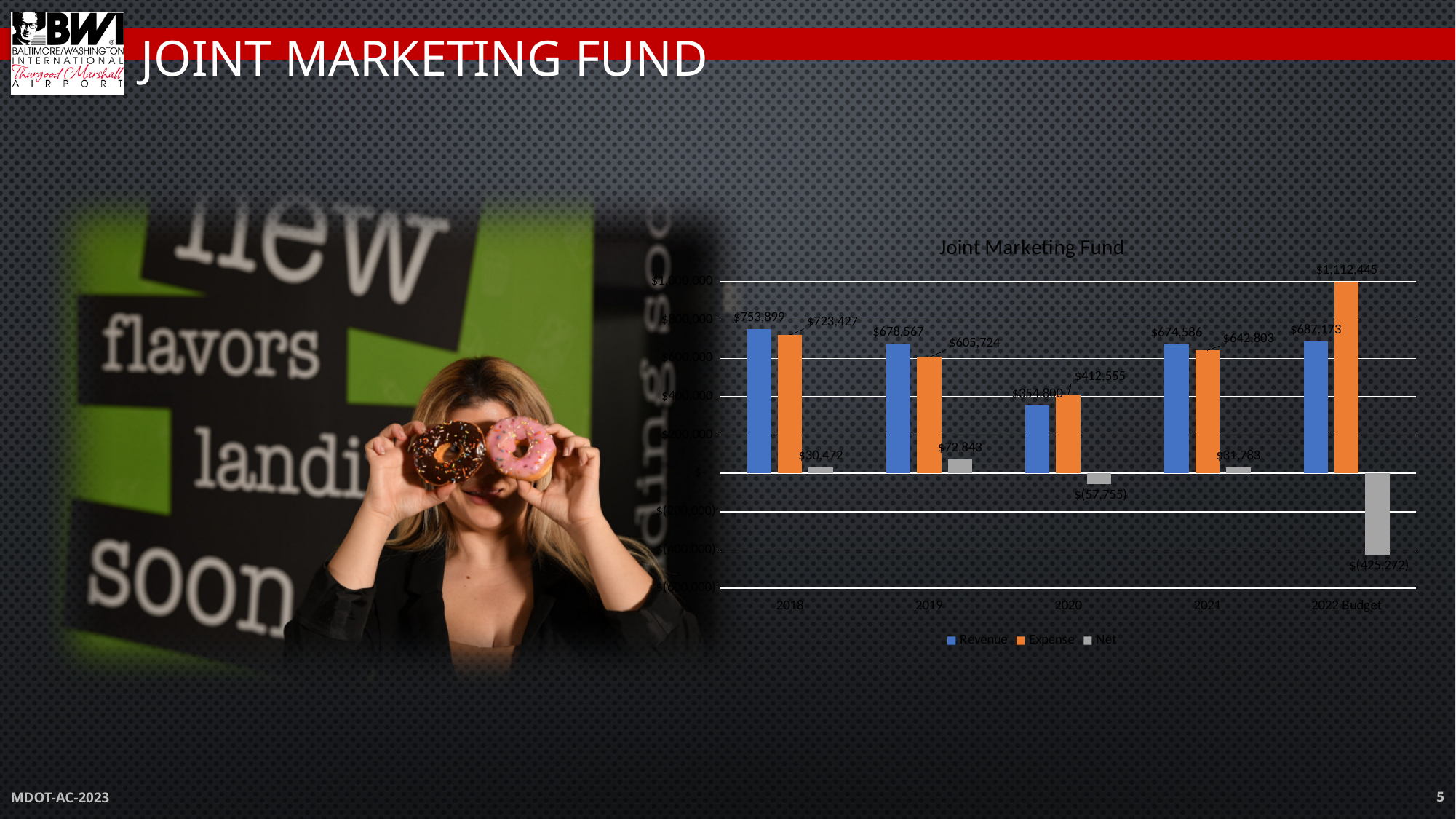
What is the Net value for 2020 in the Joint Marketing Fund chart? $(57,755) What is the Expense value for 2019 in the Joint Marketing Fund chart? $605,724 Is the Revenue value for 2022 Budget greater or less than $800,000 in the Joint Marketing Fund chart? less Which year has the highest Expense in the Joint Marketing Fund chart? 2022 Budget Which year has the lowest Revenue in the Joint Marketing Fund chart? 2020 How many series does the legend of the Joint Marketing Fund chart list? 3 What type of chart is the Joint Marketing Fund chart? Bar chart What is the Expense value for 2022 Budget in the Joint Marketing Fund chart? $1,112,445 In the Joint Marketing Fund chart, is Revenue or Expense larger for 2020? Expense How many years (categories) are shown on the x axis of the Joint Marketing Fund chart? 5 What is the Revenue value for 2018 in the Joint Marketing Fund chart? $753,899 What is the difference between Revenue and Expense for 2021 in the Joint Marketing Fund chart? $31,783